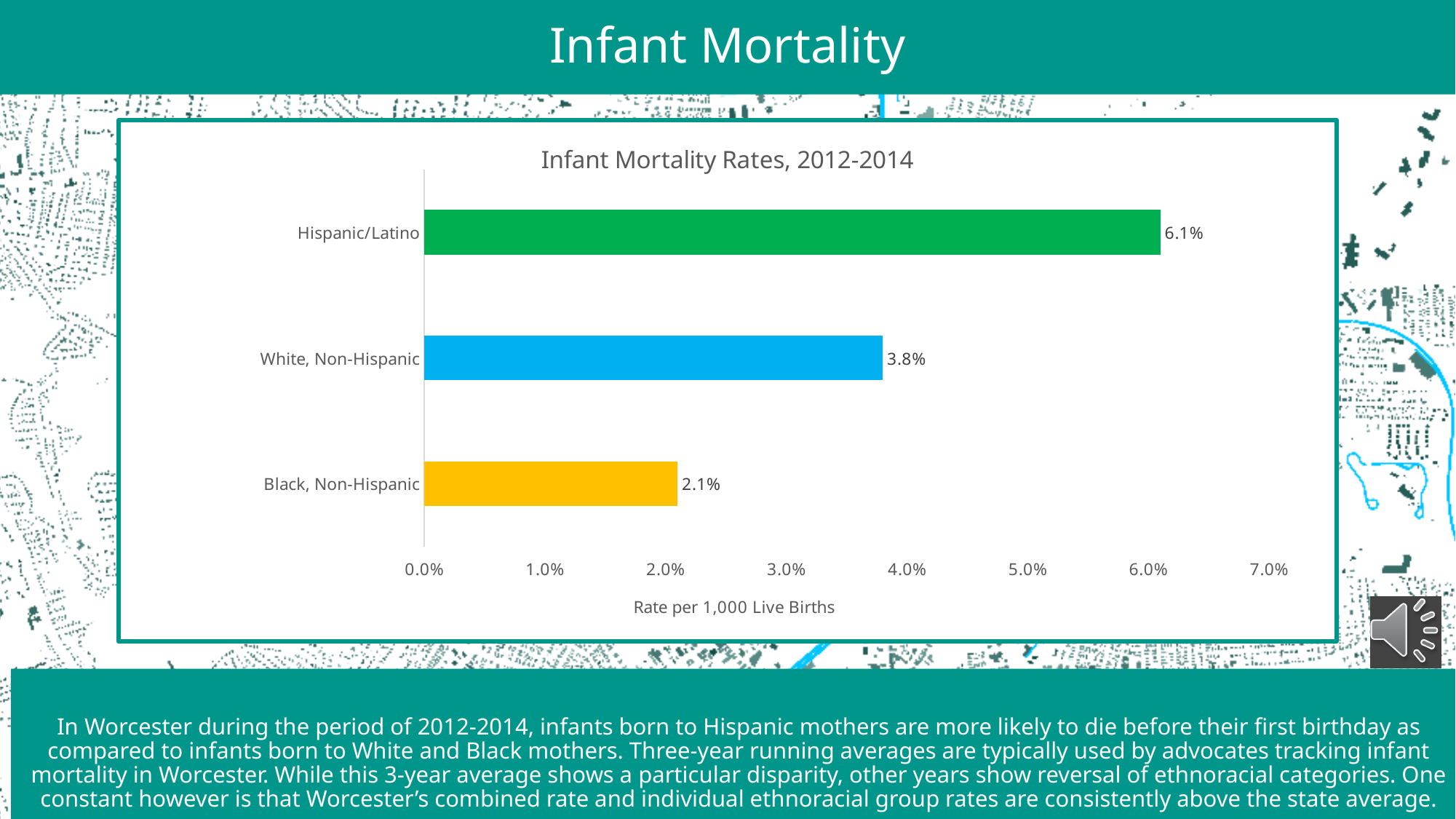
What is the title of the chart? Infant Mortality Rates, 2012-2014 What is the infant mortality rate for White, Non-Hispanic? 3.8% What is the difference between the Hispanic/Latino rate and the White, Non-Hispanic rate? 2.3% What kind of chart is shown on the slide? Bar chart Is the value for Hispanic/Latino greater or less than 5.0%? greater What is the difference between the White, Non-Hispanic rate and the Black, Non-Hispanic rate? 1.7% Which group has the highest infant mortality rate? Hispanic/Latino How many groups are shown in the chart? 3 Which is larger, the rate for White, Non-Hispanic or the rate for Black, Non-Hispanic? White, Non-Hispanic Which group has the lowest infant mortality rate? Black, Non-Hispanic What is the infant mortality rate for Black, Non-Hispanic? 2.1% What is the infant mortality rate for Hispanic/Latino? 6.1%